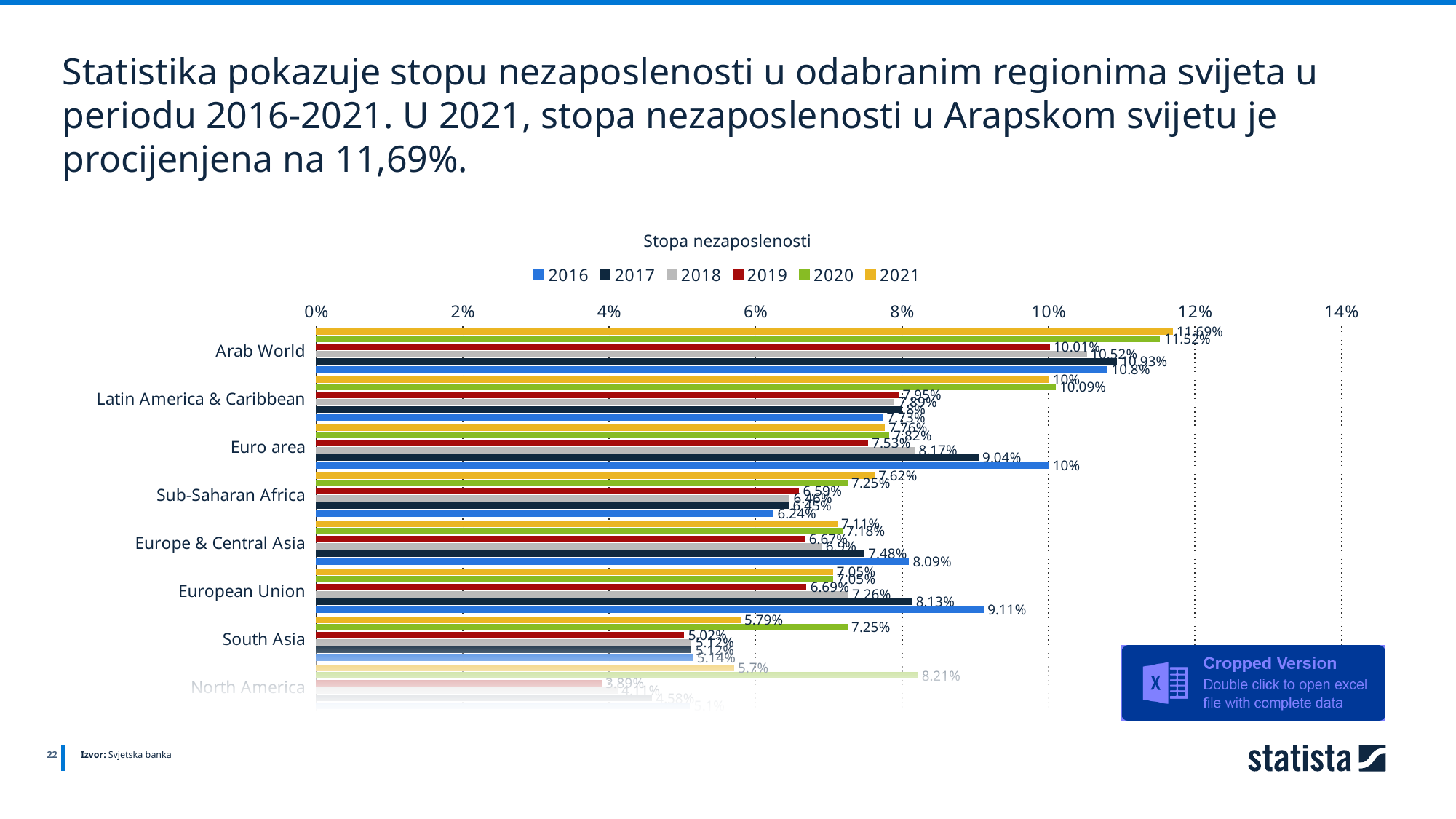
What is the difference between the Arab World unemployment rate in 2021 and in 2020? 0.17 percentage points Is the 2016 unemployment rate for Arab World greater or less than 10%? greater Which is larger: the 2016 unemployment rate for Euro area or for European Union? Euro area What is the unemployment rate for Euro area in 2016? 10% What is the unemployment rate for South Asia in 2020? 7.25% What kind of chart is shown on the slide? Bar chart What is the unemployment rate for Sub-Saharan Africa in 2016? 6.24% How many series does the legend list? 6 Which region has the highest unemployment rate in 2021? Arab World What is the unemployment rate for Arab World in 2021? 11.69% What is the unemployment rate for European Union in 2016? 9.11% Did the unemployment rate for Euro area rise or fall from 2016 to 2019? Fall